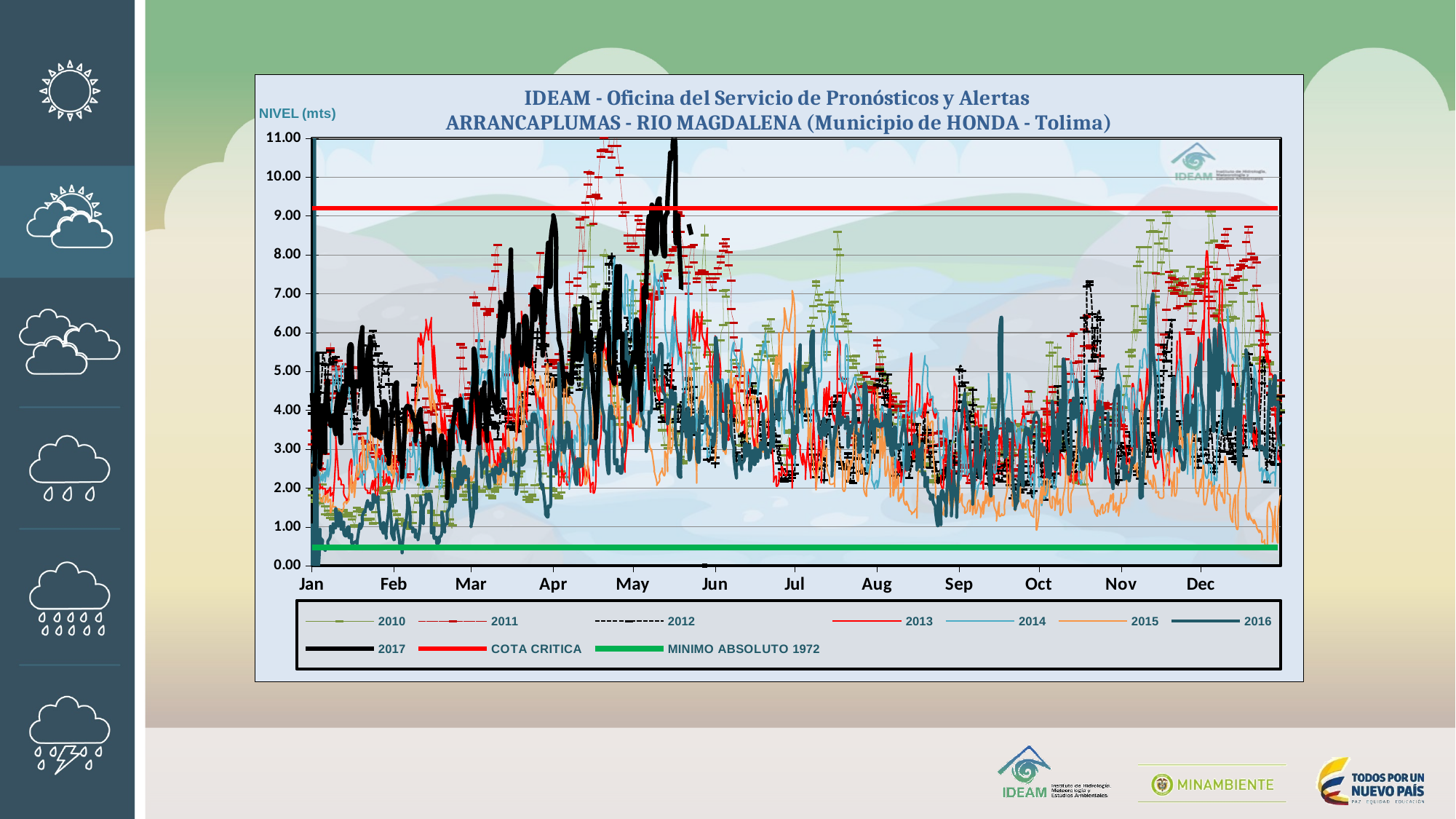
Is the 2015 series in December greater or less than 3.00? less Which month is the first label on the x axis? Jan What kind of chart is shown on the slide? line chart What is the label of the y axis? NIVEL (mts) How many series does the legend list? 10 Is the COTA CRITICA line greater or less than 9.00? greater Which legend entry is drawn as the thick black line? 2017 Which is higher, the COTA CRITICA line or the MINIMO ABSOLUTO 1972 line? COTA CRITICA Is the MINIMO ABSOLUTO 1972 line greater or less than 1.00? less What is the highest value shown on the y axis? 11.00 How many months are labelled along the x axis? 12